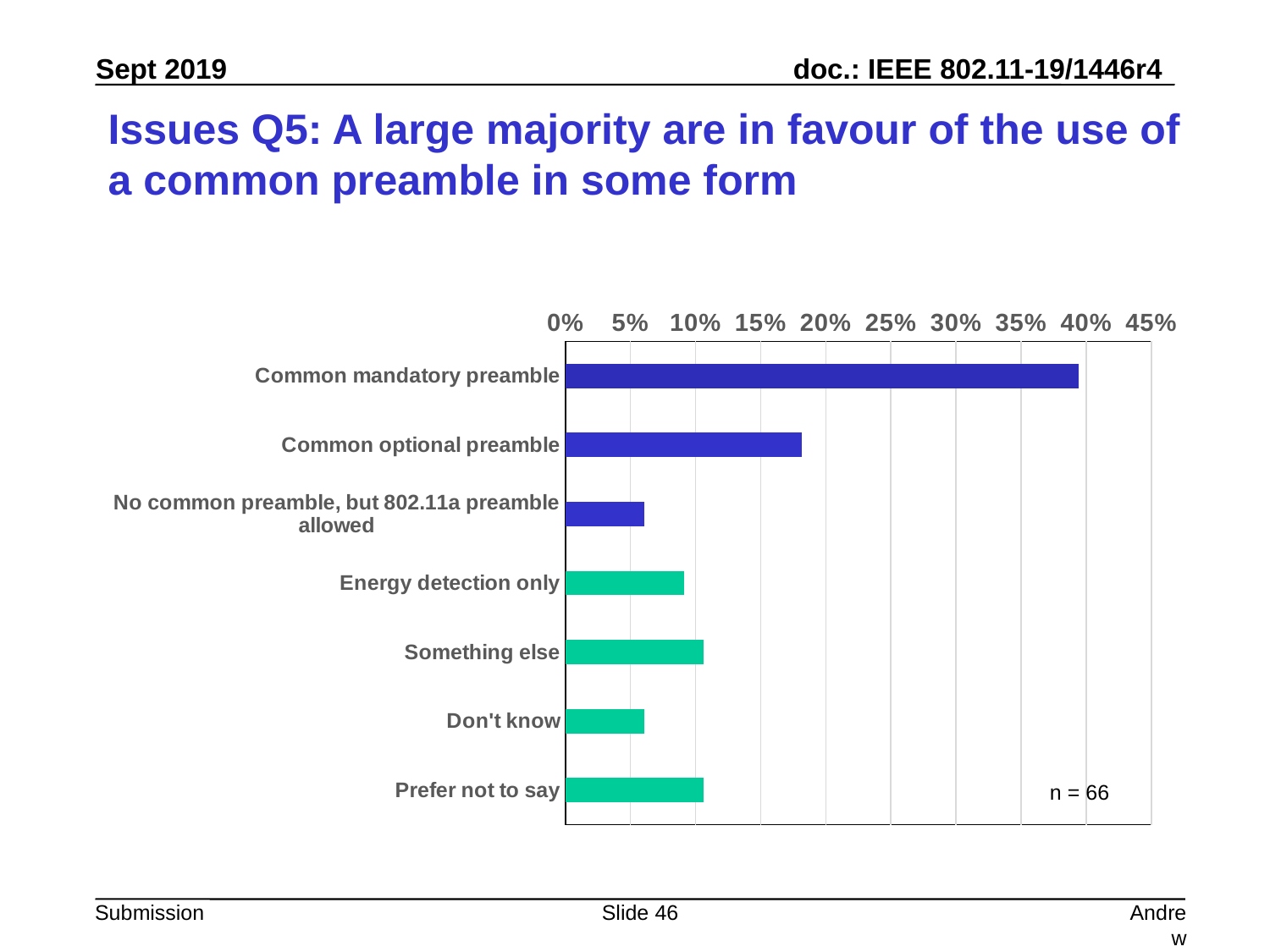
Is the value for Common mandatory preamble greater or less than 35%? greater How many categories are plotted in the chart? 7 Which is larger, the value for Common mandatory preamble or the value for Common optional preamble? Common mandatory preamble Is the value for Don't know greater or less than 10%? less Is the value for Common optional preamble greater or less than 15%? greater Which is larger, the value for Something else or the value for Don't know? Something else Which is larger, the value for Common optional preamble or the value for Energy detection only? Common optional preamble What sample size (n) is shown on the chart? n = 66 What kind of chart is shown on the slide? Bar chart Which category has the highest value in the chart? Common mandatory preamble